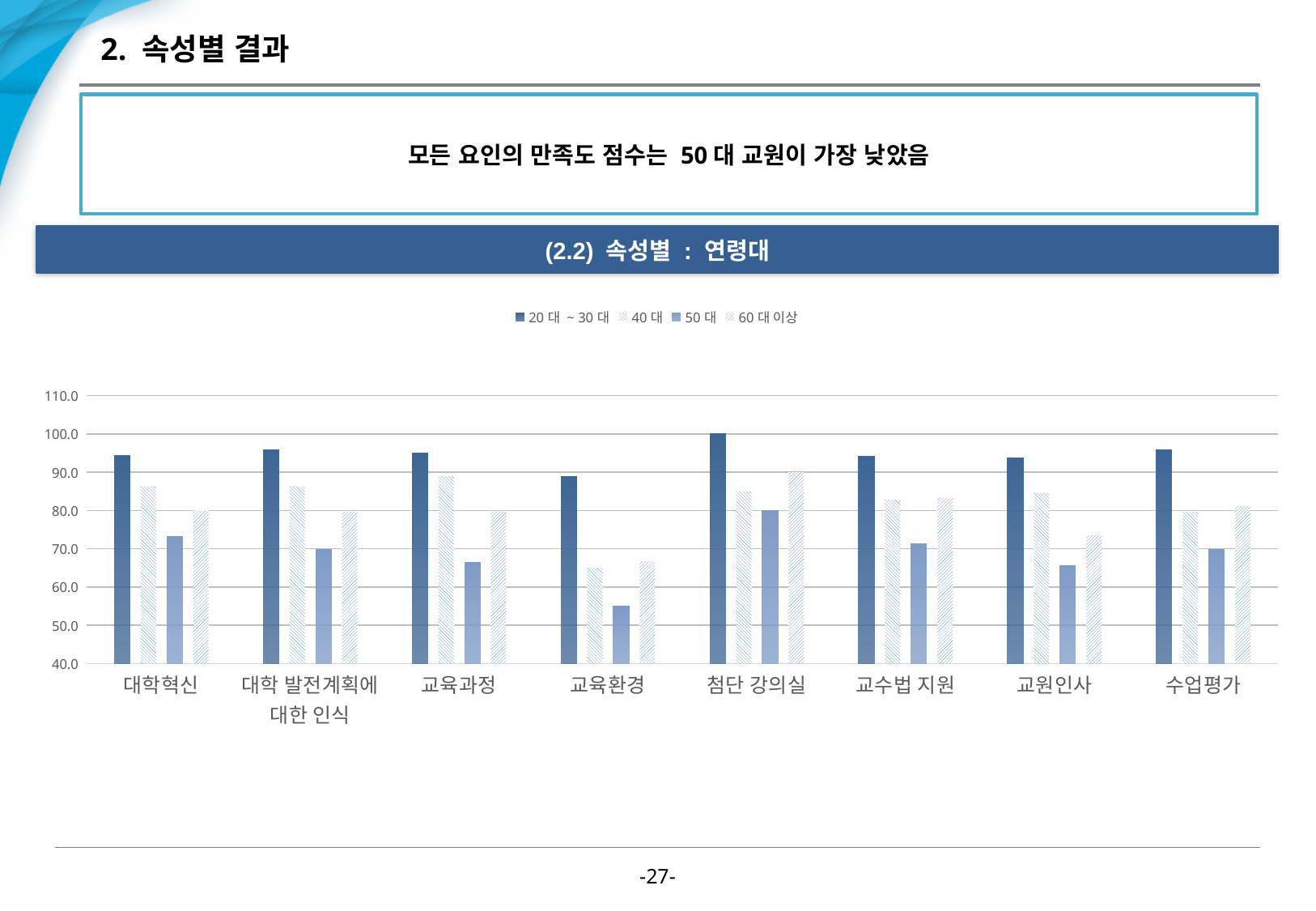
Which category has the highest value for the 20 대 ~ 30 대 series? 첨단 강의실 What is the title of the section banner above the chart? (2.2) 속성별 : 연령대 Which category has the lowest value for the 50 대 series? 교육환경 Is the value for 20 대 ~ 30 대 in 첨단 강의실 greater or less than 90? greater What kind of chart is shown on the slide? bar chart Is the value for 40 대 in 교육환경 greater or less than 70? less How many series does the legend list? 4 Is the value for 50 대 in 대학혁신 greater or less than 70? greater In 대학혁신, which is larger: the value for 20 대 ~ 30 대 or the value for 50 대? 20 대 ~ 30 대 In 교육환경, which is larger: the value for 40 대 or the value for 50 대? 40 대 How many categories are shown along the x axis? 8